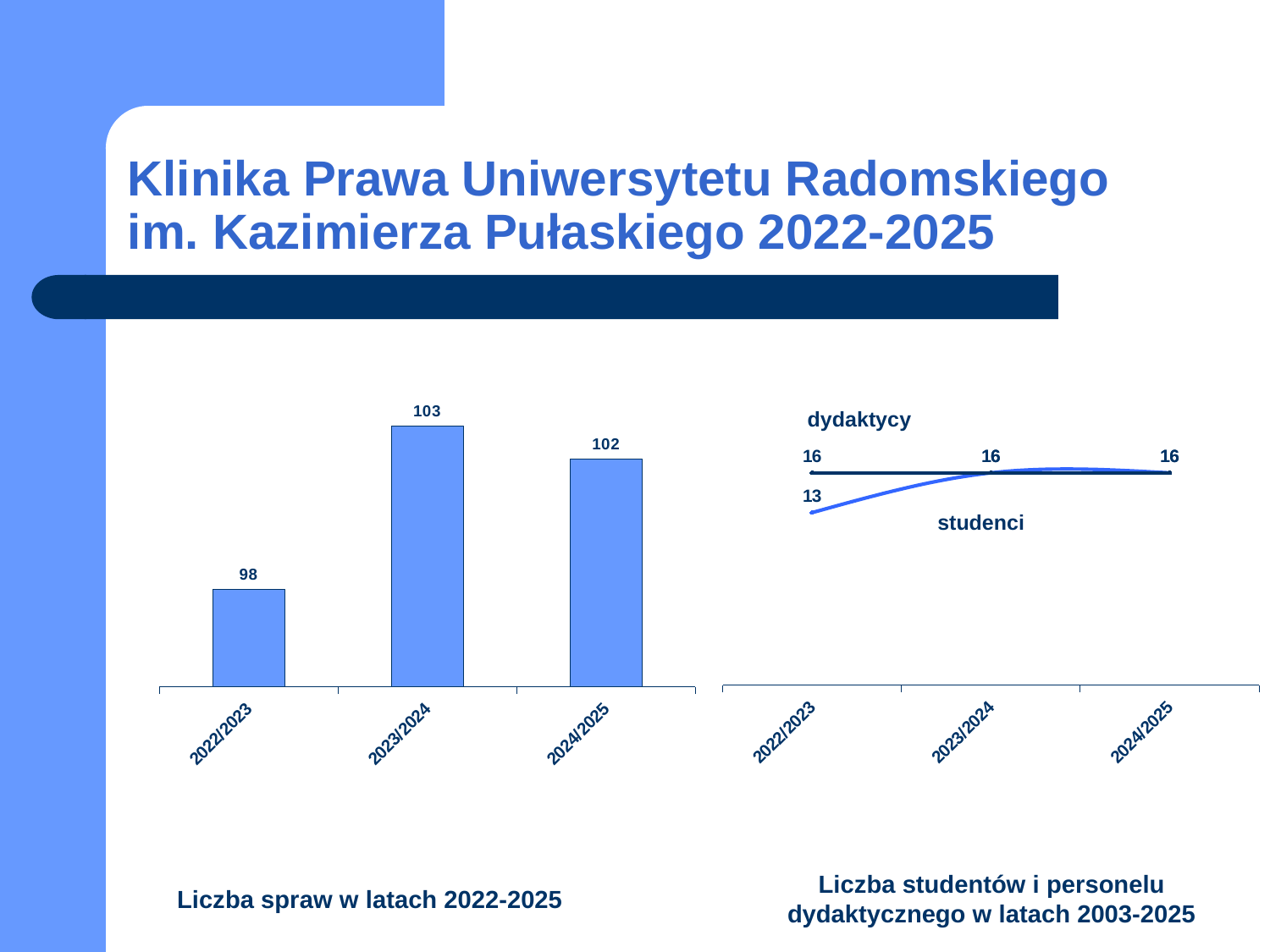
In the left chart (Liczba spraw w latach 2022-2025), which year has the highest value? 2023/2024 What kind of chart is the left chart (Liczba spraw w latach 2022-2025)? Bar chart In the left chart (Liczba spraw w latach 2022-2025), what is the value for 2024/2025? 102 What kind of chart is the right chart (Liczba studentów i personelu dydaktycznego)? Line chart In the left chart (Liczba spraw w latach 2022-2025), which year has the lowest value? 2022/2023 In the left chart (Liczba spraw w latach 2022-2025), how many bars are there? 3 In the right chart (Liczba studentów i personelu dydaktycznego), what is the value for dydaktycy in 2022/2023? 16 In the left chart (Liczba spraw w latach 2022-2025), what is the value for 2023/2024? 103 In the left chart (Liczba spraw w latach 2022-2025), what is the value for 2022/2023? 98 In the left chart (Liczba spraw w latach 2022-2025), what is the difference between the values for 2023/2024 and 2022/2023? 5 In the right chart (Liczba studentów i personelu dydaktycznego), which series has the larger value in 2022/2023, dydaktycy or studenci? dydaktycy In the right chart (Liczba studentów i personelu dydaktycznego), what is the value for studenci in 2022/2023? 13